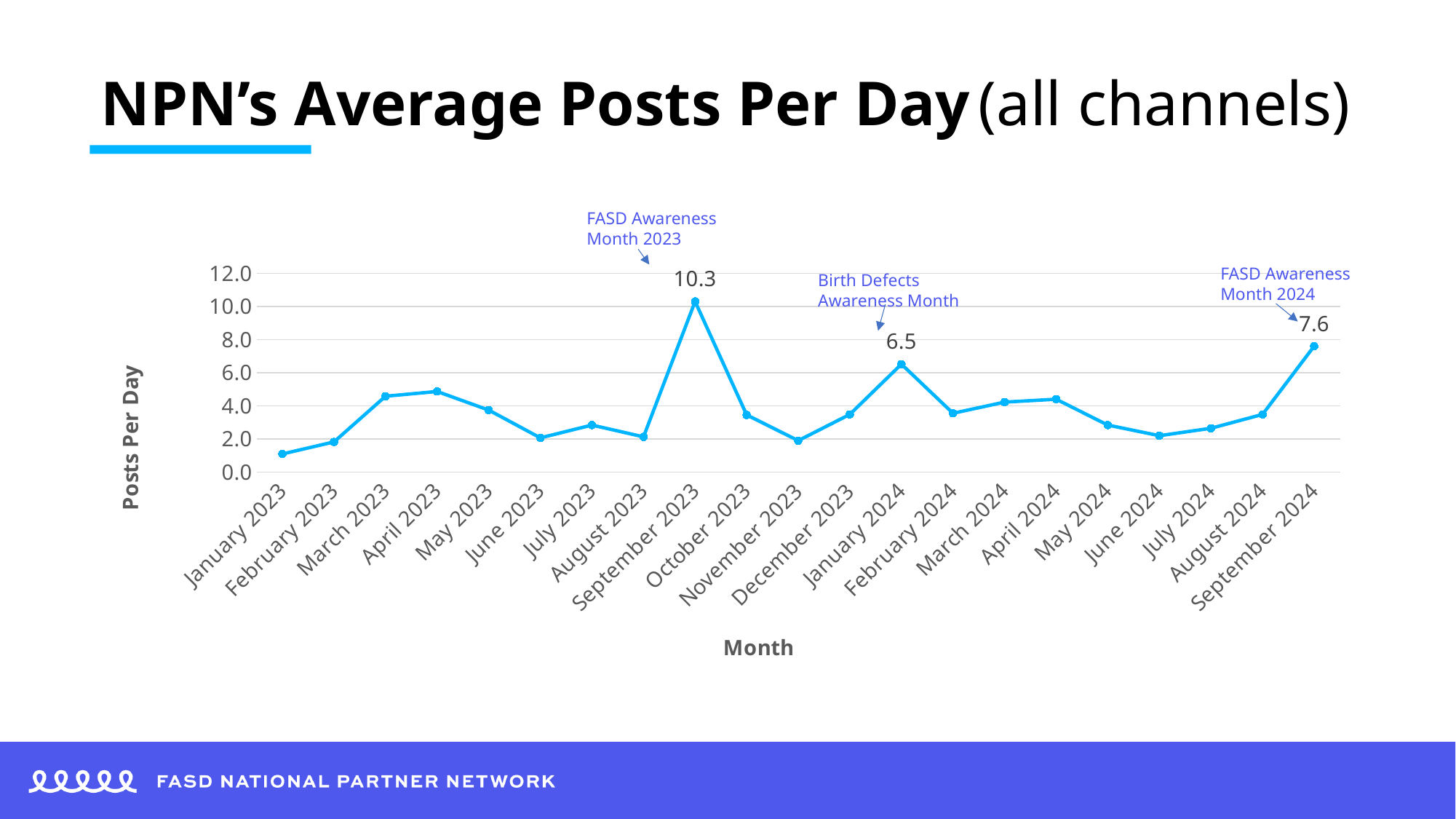
What is the average posts per day for January 2024? 6.5 Which month has a higher average posts per day, September 2023 or September 2024? September 2023 What is the difference in average posts per day between September 2024 and January 2024? 1.1 How many months are plotted on the chart? 21 Is the value for October 2023 greater or less than 4.0? less What is the average posts per day for September 2024? 7.6 What is the difference in average posts per day between September 2023 and January 2024? 3.8 What is the average posts per day for September 2023? 10.3 What type of chart is shown on the slide? Line chart Which month has the highest average posts per day? September 2023 Which annotation is attached to the September 2023 peak? FASD Awareness Month 2023 Which month has the lowest average posts per day? January 2023